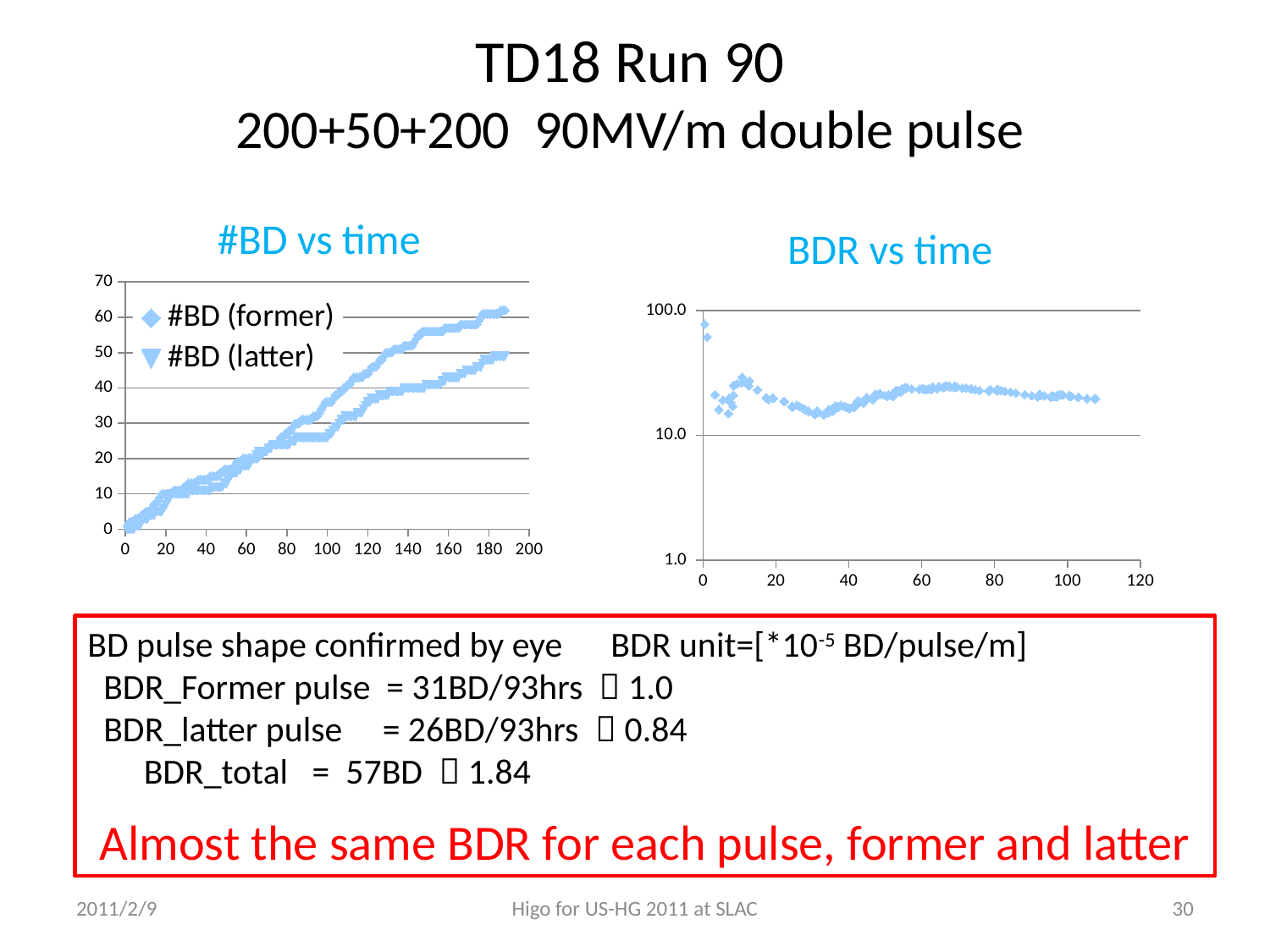
What kind of chart is the '#BD vs time' chart? scatter chart In the '#BD vs time' chart, what is the highest value shown on the y axis? 70 What kind of chart is the 'BDR vs time' chart? scatter chart In the 'BDR vs time' chart, is the first point (near time 0) greater or less than 10.0? greater In the 'BDR vs time' chart, is the value at time 100 greater or less than 100.0? less In the 'BDR vs time' chart, is the value at time 60 greater or less than 10.0? greater In the '#BD vs time' chart, how many series does the legend list? 2 In the '#BD vs time' chart, do the values rise or fall as time increases along the x axis? rise In the '#BD vs time' chart, what are the two series named in the legend? #BD (former) and #BD (latter) In the '#BD vs time' chart, which series has the higher value at time 180, #BD (former) or #BD (latter)? #BD (former)